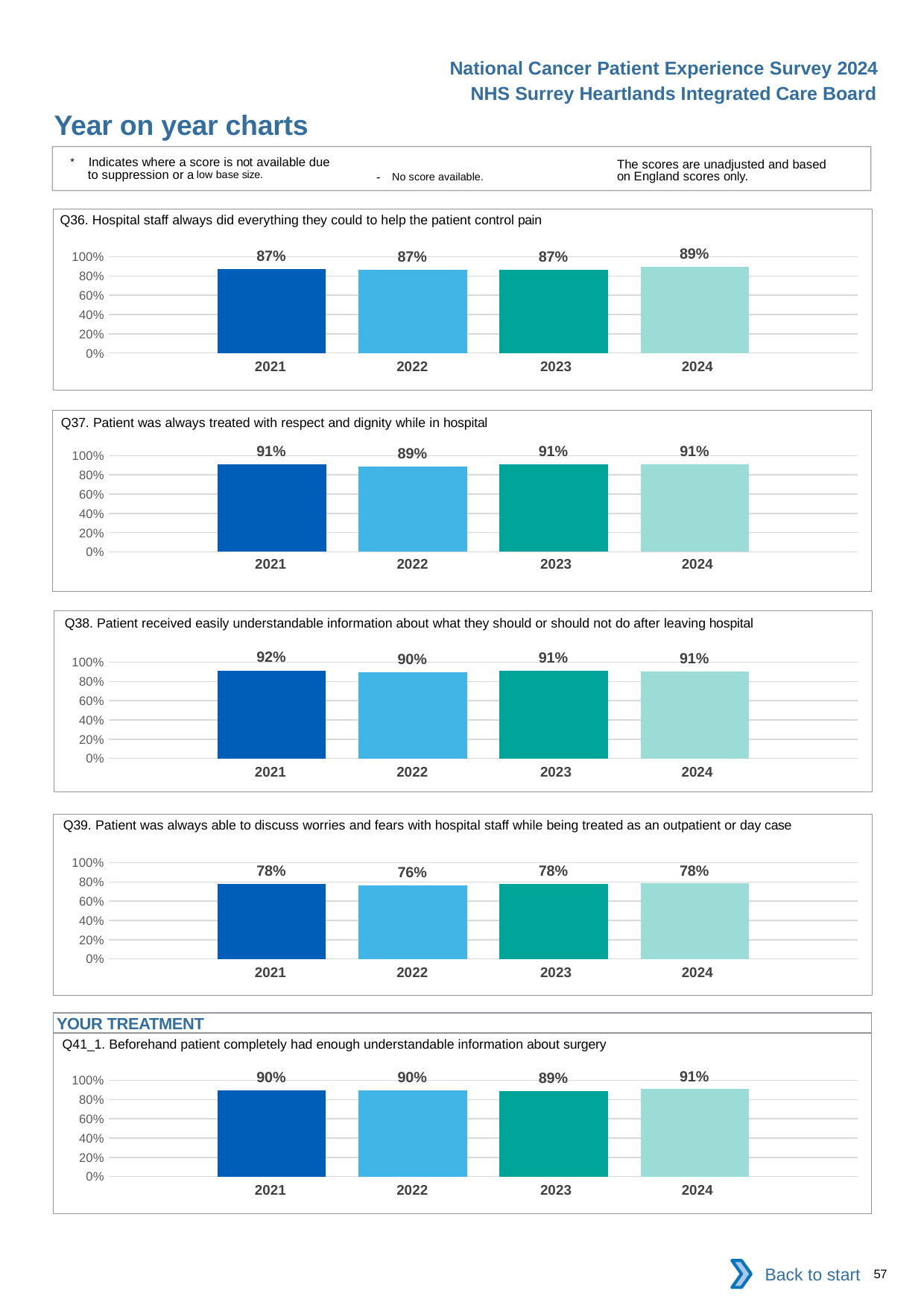
In the Q41_1 chart (Beforehand patient completely had enough understandable information about surgery), what is the difference between the 2024 value and the 2023 value? 2% What kind of chart is the Q41_1 chart? bar chart In the Q41_1 chart, what is the value for 2021? 90% In the Q37 chart (Patient was always treated with respect and dignity while in hospital), which year has the lowest value? 2022 In the Q36 chart, what is the value for 2022? 87% In the Q39 chart (Patient was always able to discuss worries and fears with hospital staff while being treated as an outpatient or day case), what is the value for 2022? 76% In the Q38 chart (Patient received easily understandable information about what they should or should not do after leaving hospital), which year has the highest value? 2021 In the Q38 chart, what is the difference between the 2021 value and the 2022 value? 2% In the Q39 chart, is the value for 2023 greater or less than 60%? greater How many years are shown in the Q36 chart? 4 In the Q36 chart (Hospital staff always did everything they could to help the patient control pain), what is the value for 2024? 89% In the Q37 chart, is the value for 2021 larger or smaller than the value for 2022? larger